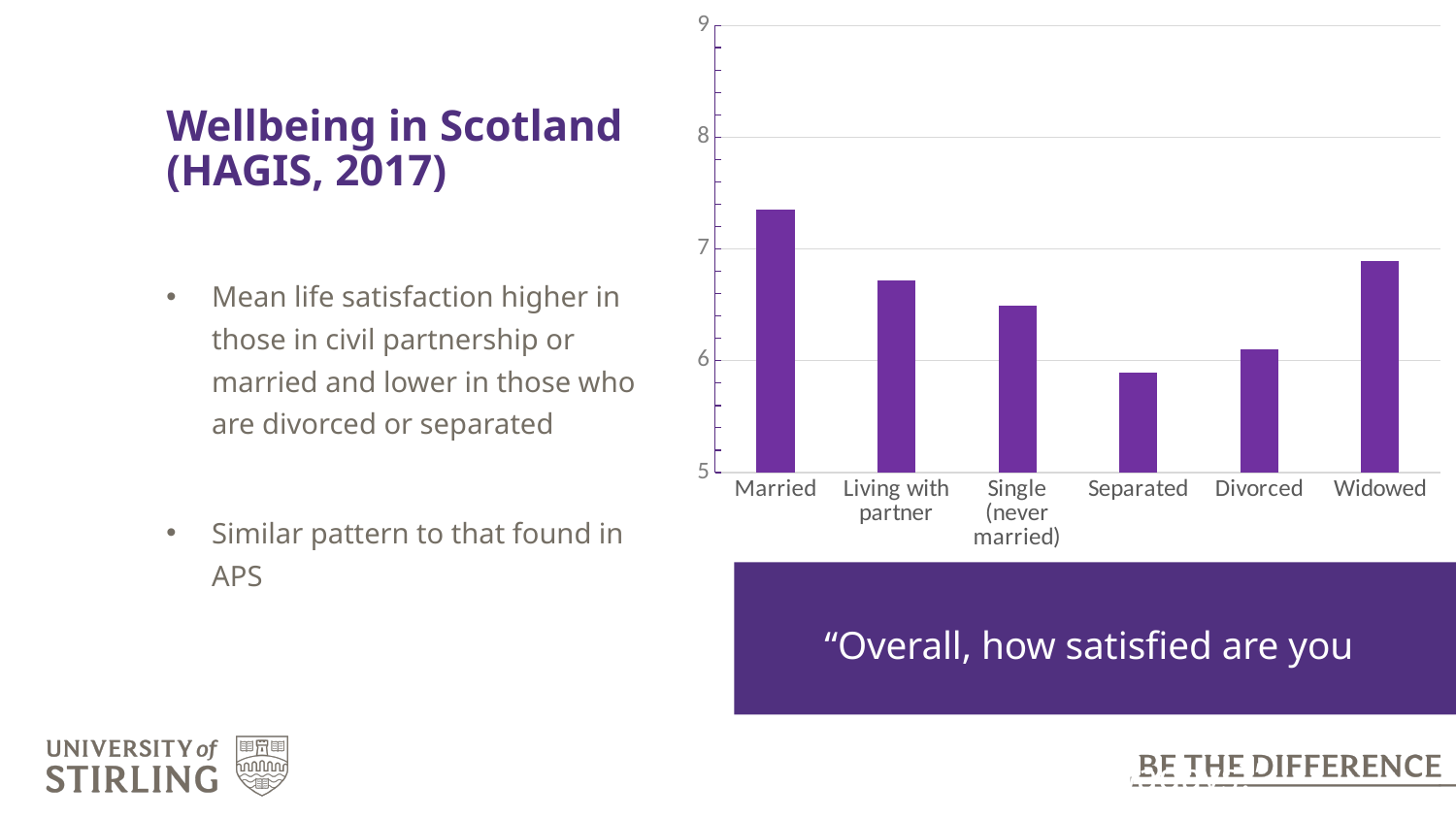
Which is larger, the value for Married or the value for Widowed? Married Is the value for Married greater or less than 7? greater Which category has the highest bar in the chart? Married What is the lowest value shown on the chart's vertical axis? 5 How many categories are shown on the x axis of the chart? 6 Is the value for Separated greater or less than 6? less Which is larger, the value for Living with partner or the value for Single (never married)? Living with partner Is the value for Living with partner greater or less than 7? less What kind of chart is shown on the slide? bar chart Which category has the lowest bar in the chart? Separated What colour are the bars in the chart? purple